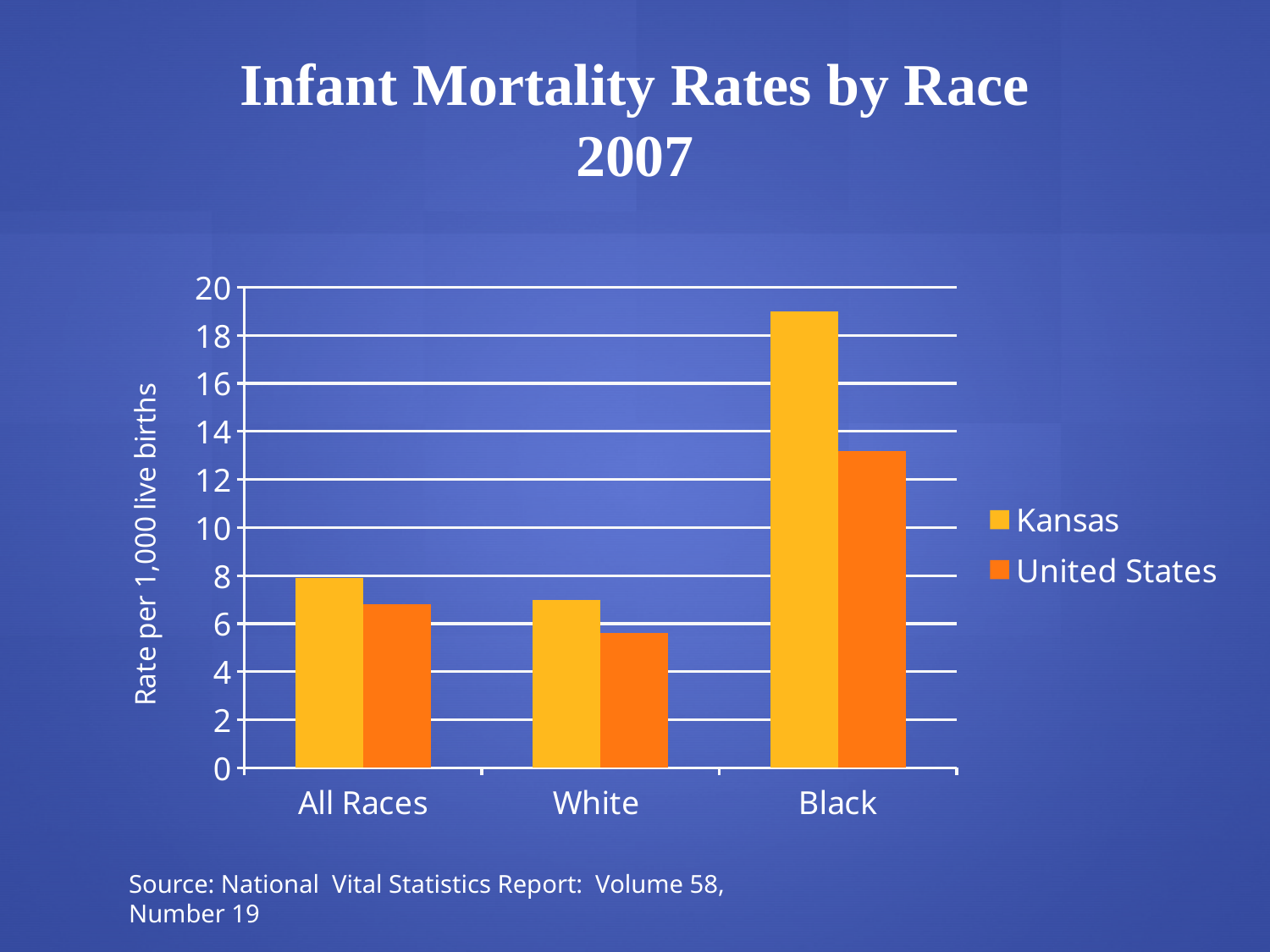
For the Black category, which is larger: the Kansas rate or the United States rate? Kansas Is the Kansas value for White greater or less than 6? greater Which category has the highest Kansas infant mortality rate? Black How many race categories are shown on the x axis? 3 Is the United States value for Black greater or less than 14? less What is the label on the vertical axis? Rate per 1,000 live births Is the Kansas value for Black greater or less than 18? greater How many series does the legend list? 2 Which series is shown in the darker orange colour? United States Which category has the lowest United States infant mortality rate? White What kind of chart is shown on the slide? bar chart